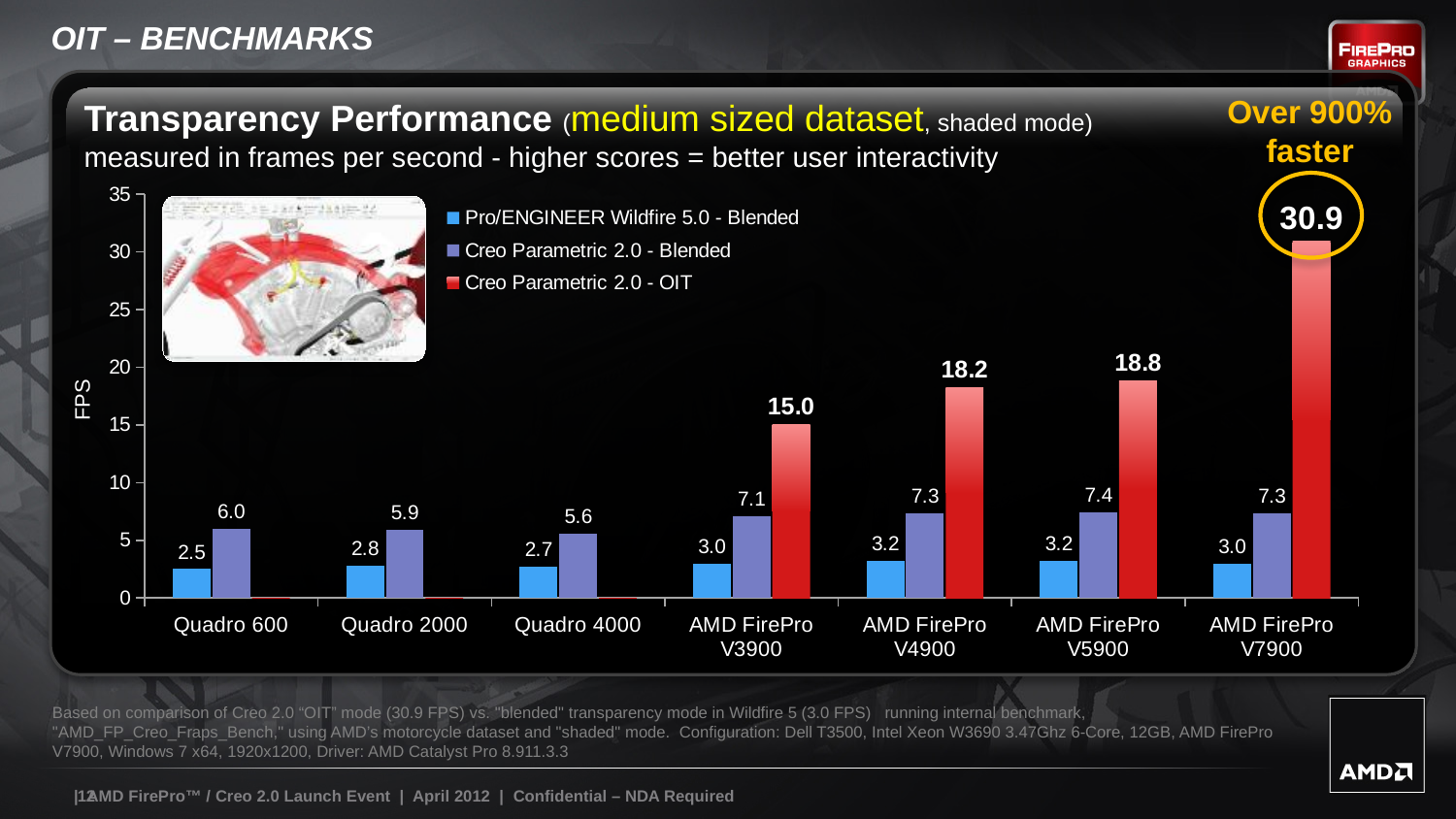
Which category has the highest Creo Parametric 2.0 - OIT value? AMD FirePro V7900 Which is larger for AMD FirePro V7900: the Creo Parametric 2.0 - OIT value or the Creo Parametric 2.0 - Blended value? Creo Parametric 2.0 - OIT What kind of chart is shown on the slide? Bar chart What is the Creo Parametric 2.0 - Blended value for Quadro 600? 6.0 What is the label of the y axis? FPS What is the Pro/ENGINEER Wildfire 5.0 - Blended value for AMD FirePro V4900? 3.2 How many categories are shown on the x axis? 7 What is the difference between the Creo Parametric 2.0 - OIT values for AMD FirePro V5900 and AMD FirePro V4900? 0.6 Which category has the lowest Pro/ENGINEER Wildfire 5.0 - Blended value? Quadro 600 What is the Creo Parametric 2.0 - OIT value for AMD FirePro V7900? 30.9 What is the Creo Parametric 2.0 - OIT value for AMD FirePro V3900? 15.0 How many series does the legend list? 3